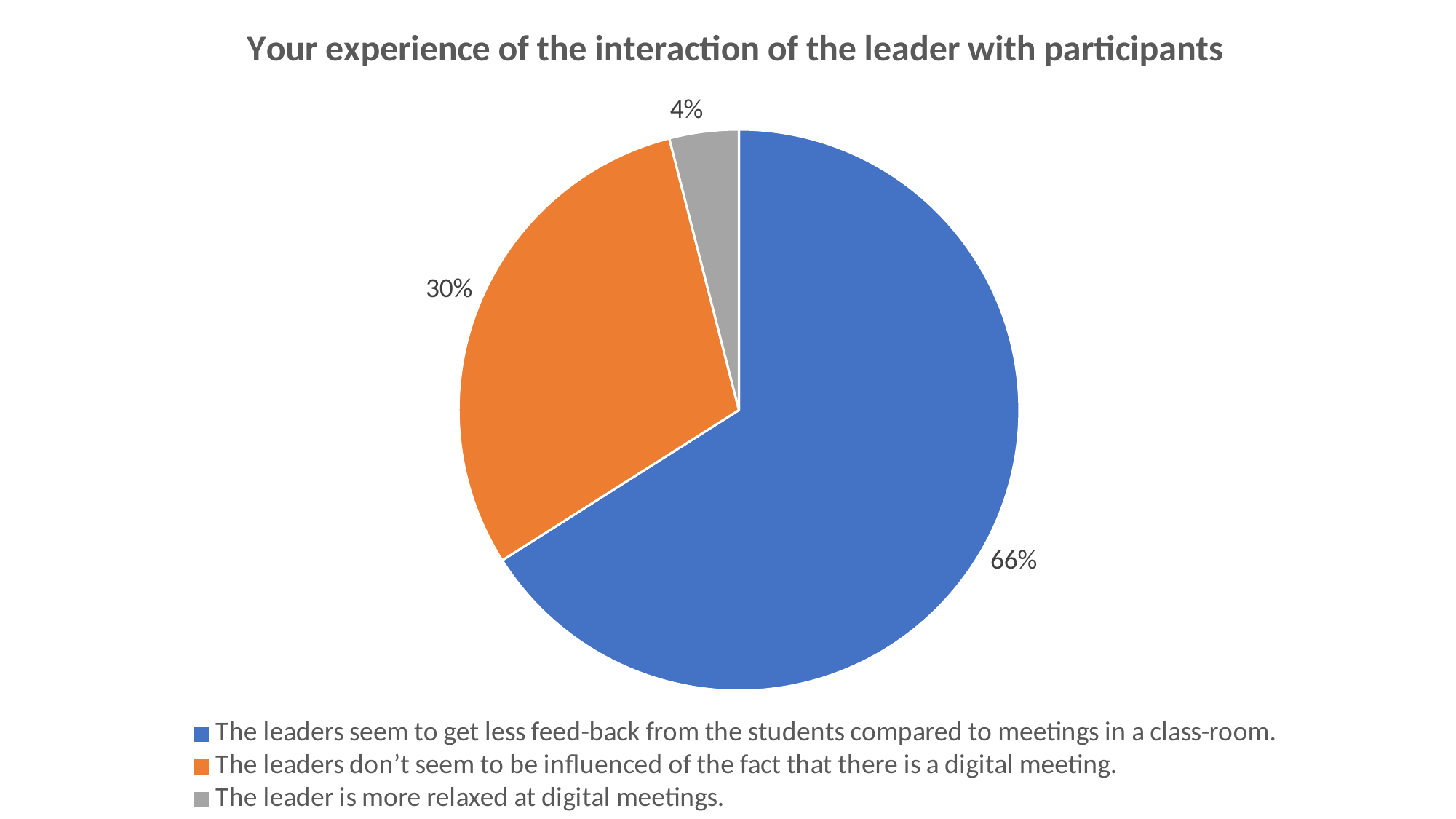
Which category has the smallest slice of the pie? The leader is more relaxed at digital meetings. What colour is the slice for 'The leader is more relaxed at digital meetings.'? grey What is the chart's title? Your experience of the interaction of the leader with participants Which is larger: the share for 'The leaders don't seem to be influenced of the fact that there is a digital meeting.' or the share for 'The leader is more relaxed at digital meetings.'? The leaders don't seem to be influenced of the fact that there is a digital meeting. Which category has the largest slice of the pie? The leaders seem to get less feed-back from the students compared to meetings in a class-room. What share of the pie is 'The leaders seem to get less feed-back from the students compared to meetings in a class-room.'? 66% What is the difference in percentage points between the largest slice (66%) and the 30% slice? 36 What share of the pie is 'The leaders don't seem to be influenced of the fact that there is a digital meeting.'? 30% How many categories does the pie chart have? 3 What kind of chart is shown on the slide? pie chart What is the difference in percentage points between the 30% slice and the 4% slice? 26 What share of the pie is 'The leader is more relaxed at digital meetings.'? 4%